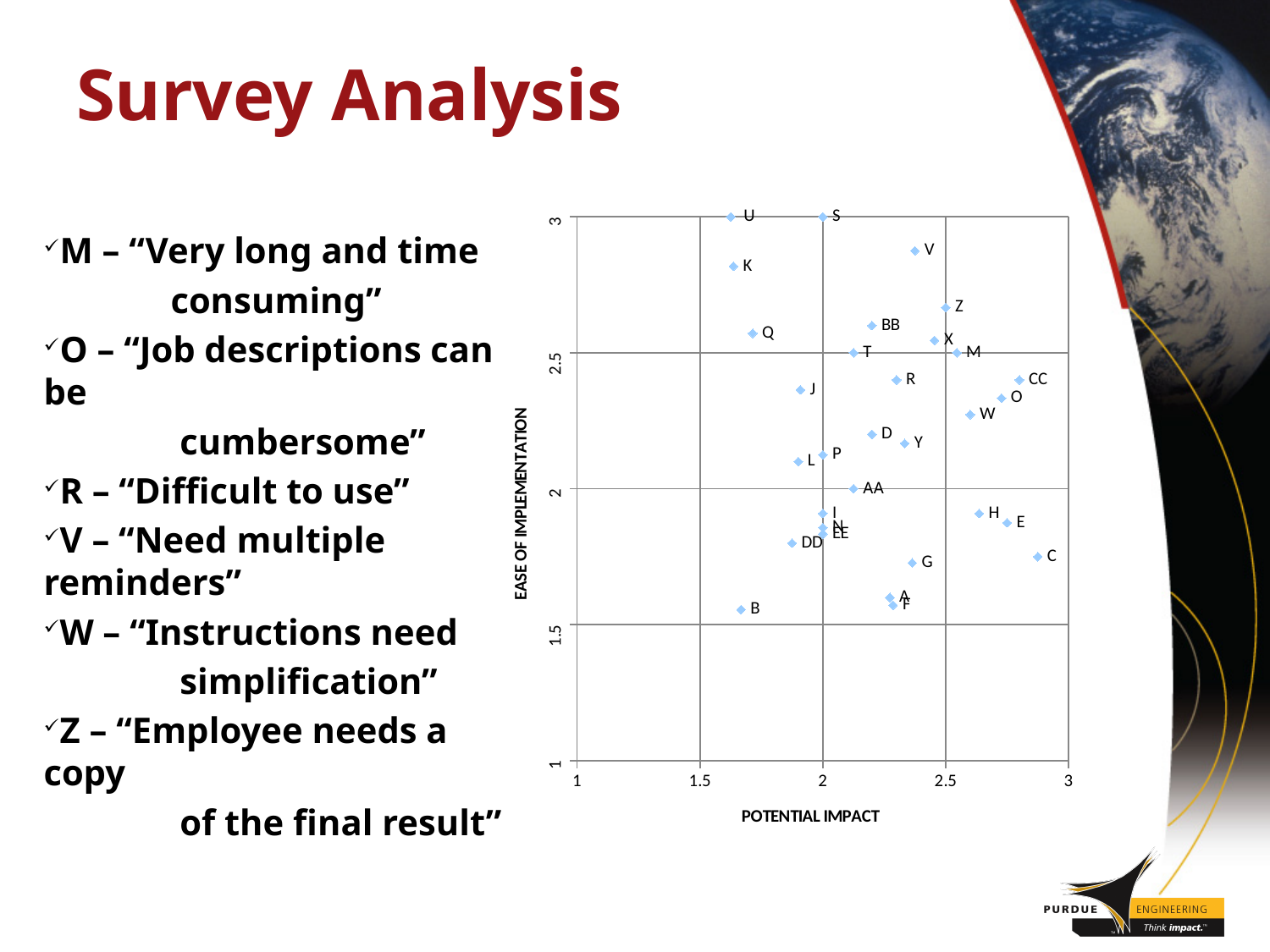
What kind of chart is shown on the slide? scatter chart Is the ease of implementation for point V greater or less than 2.5? greater Which point has a higher ease of implementation, V or G? V Is the ease of implementation for point B greater or less than 2? less Is the ease of implementation for point H greater or less than 2? less What is the ease of implementation value for point S? 3 What is the title of the vertical axis of the chart? EASE OF IMPLEMENTATION What is the title of the horizontal axis of the chart? POTENTIAL IMPACT Which point has a higher potential impact, C or B? C What is the ease of implementation value for point U? 3